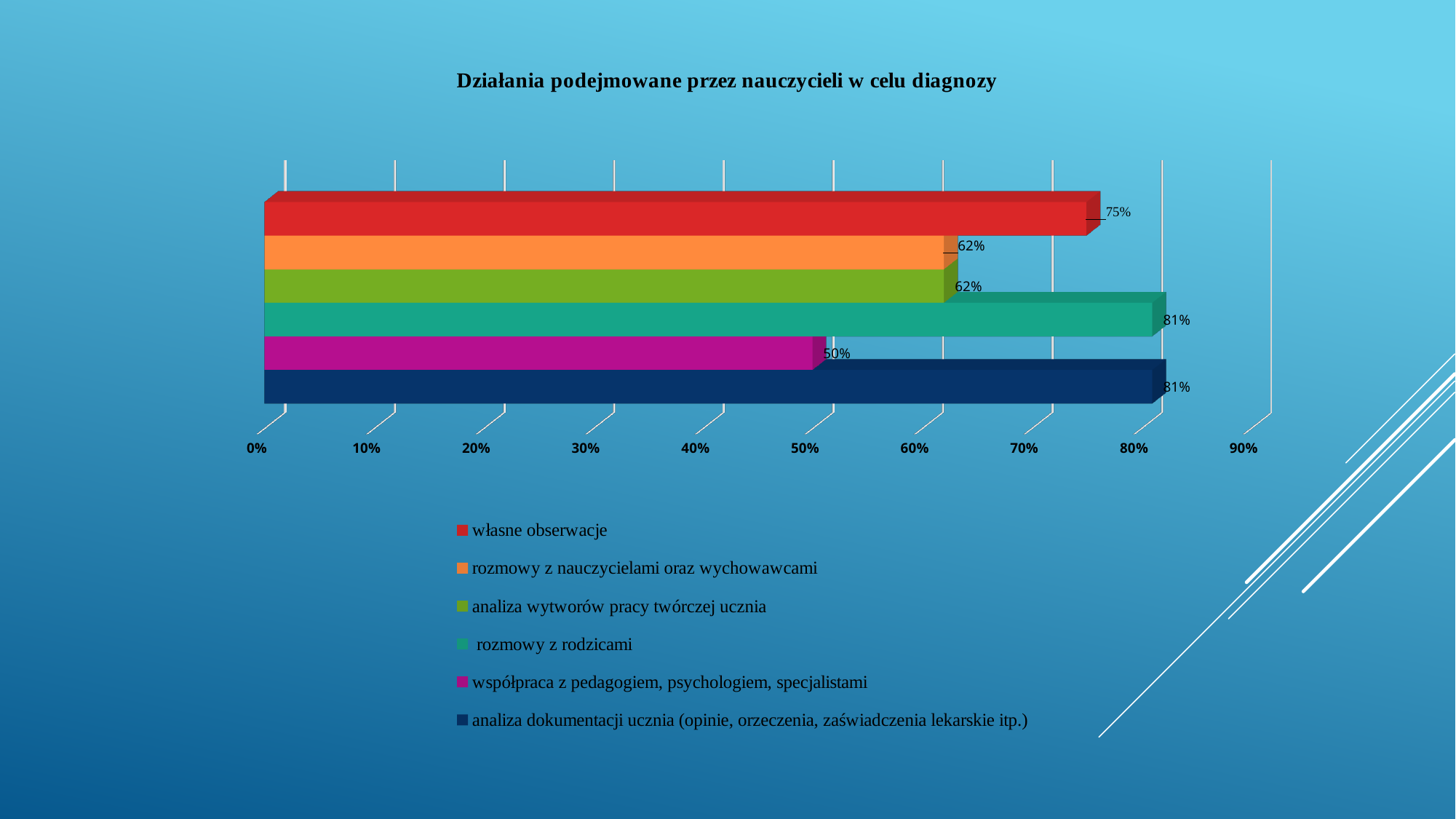
How many bars are plotted in the chart? 6 What is the value for "analiza wytworów pracy twórczej ucznia"? 62% What kind of chart is shown on the slide? bar chart What is the value for "rozmowy z rodzicami"? 81% How many entries does the legend list? 6 What is the value for "własne obserwacje"? 75% What is the difference between the values for "własne obserwacje" and "współpraca z pedagogiem, psychologiem, specjalistami"? 25% Which is larger: the value for "własne obserwacje" or the value for "rozmowy z nauczycielami oraz wychowawcami"? własne obserwacje What is the difference between the values for "rozmowy z rodzicami" and "własne obserwacje"? 6% Which category has the lowest value? współpraca z pedagogiem, psychologiem, specjalistami What is the value for "współpraca z pedagogiem, psychologiem, specjalistami"? 50% What is the value for "analiza dokumentacji ucznia (opinie, orzeczenia, zaświadczenia lekarskie itp.)"? 81%